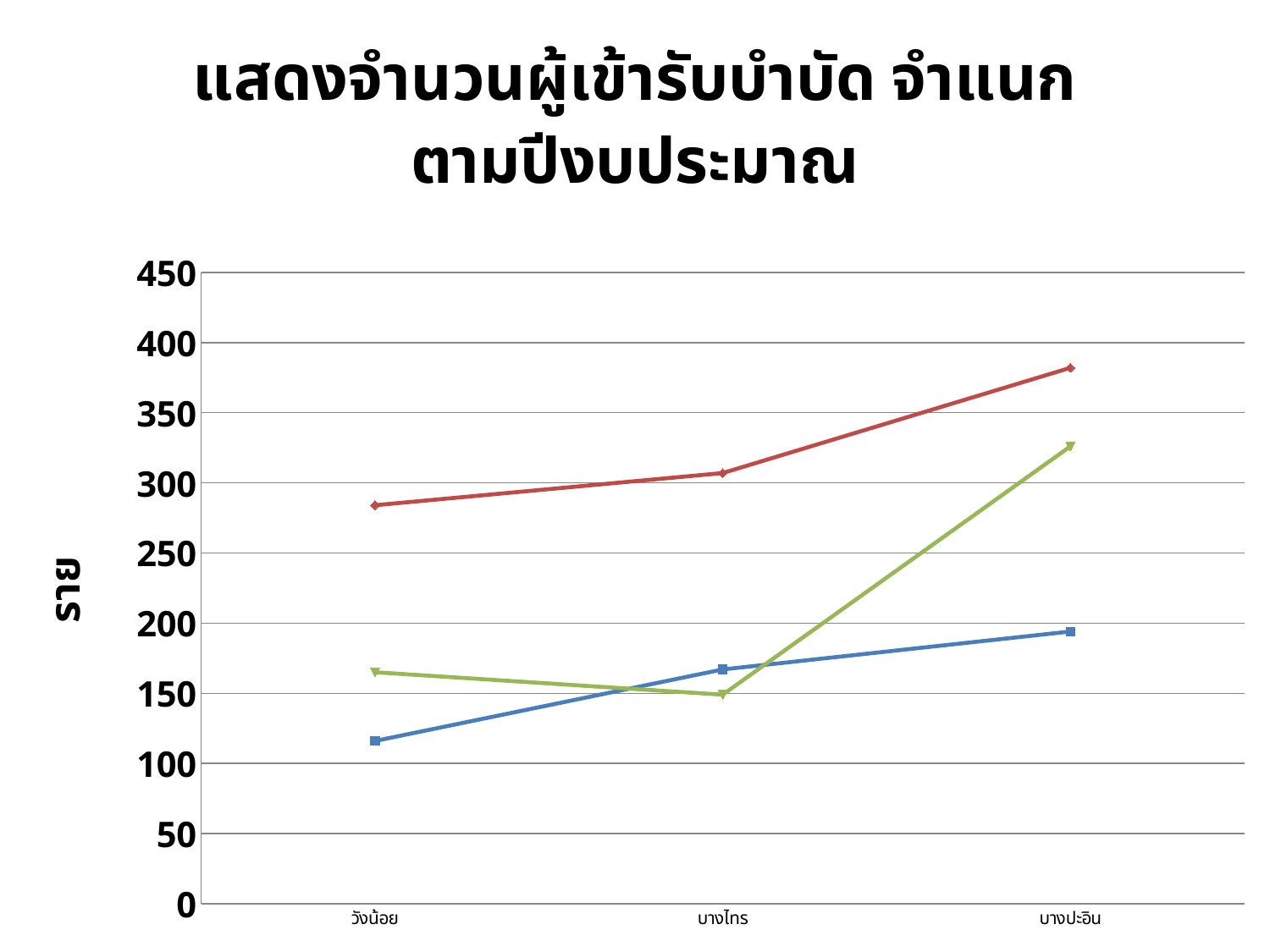
Is the value of the green line for บางไทร greater or less than 200? less Is the value of the green line for บางปะอิน greater or less than 300? greater Is the value of the blue line for วังน้อย greater or less than 150? less How many lines are plotted on the chart? 3 What is the label on the vertical axis of the chart? ราย For which category does the red line reach its highest value? บางปะอิน What kind of chart is shown on the slide? line chart At วังน้อย, which line has the larger value, the red line or the green line? red line Does the red line rise or fall from วังน้อย to บางปะอิน? rise How many categories are shown on the x axis? 3